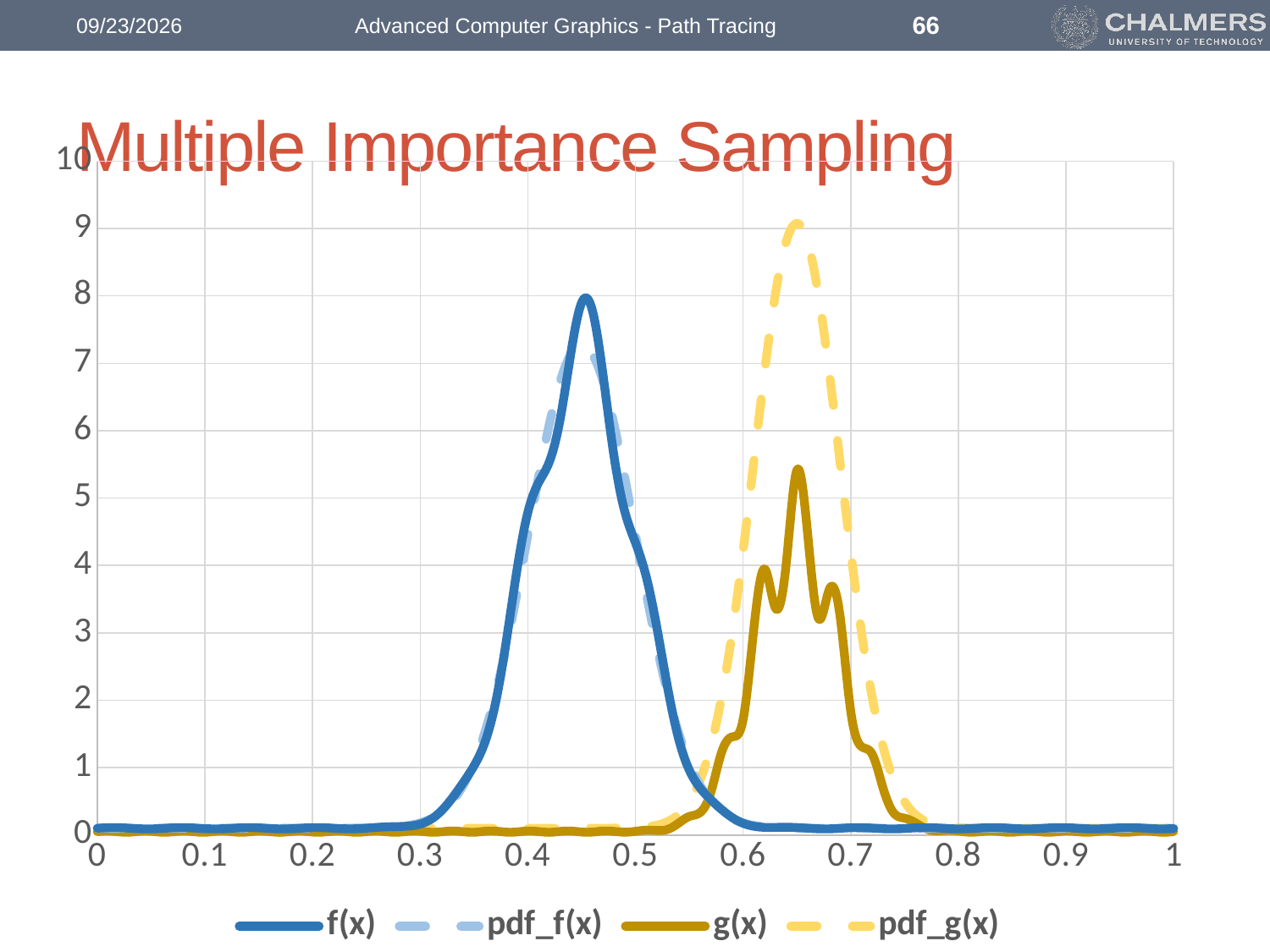
Which series reaches a higher peak, f(x) or g(x)? f(x) Which series has the lowest peak on the chart? g(x) Is the peak value of f(x) greater or less than 7? greater How many series does the legend list? 4 What kind of chart is shown on the slide? line chart What is the maximum value shown on the vertical axis? 10 Which legend entries are drawn with dashed lines? pdf_f(x) and pdf_g(x) Is the peak value of g(x) greater or less than 6? less Which series reaches the highest peak on the chart? pdf_g(x) Is the value of f(x) at x = 0.6 greater or less than 1? less Does f(x) rise or fall as x goes from 0.3 to 0.45? rise